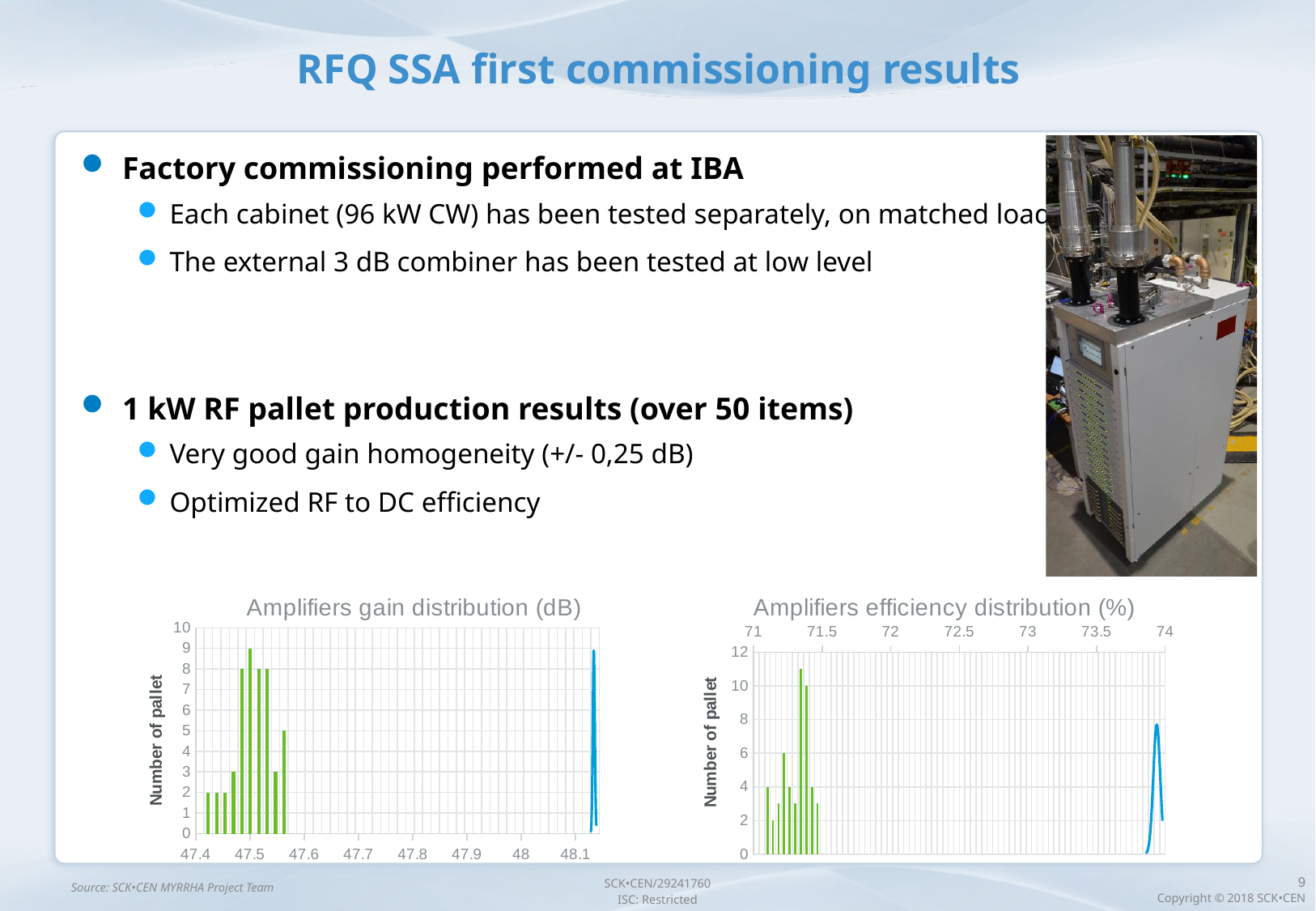
In the 'Amplifiers efficiency distribution (%)' chart, is the leftmost bar greater or less than 6? less In the 'Amplifiers gain distribution (dB)' chart, is the tallest bar greater or less than 5? greater What is the title of the chart on the right of the slide? Amplifiers efficiency distribution (%) What is the highest value shown on the y-axis of the 'Amplifiers efficiency distribution (%)' chart? 12 In the 'Amplifiers gain distribution (dB)' chart, what is the height of the tallest bar? 9 In the 'Amplifiers gain distribution (dB)' chart, is the rightmost bar greater or less than 4? greater In the 'Amplifiers efficiency distribution (%)' chart, is the tallest bar located below 72 or above 72 on the x-axis? below 72 In the 'Amplifiers gain distribution (dB)' chart, are the bars near 47.5 taller or shorter than the bars near 47.4? taller What is the y-axis label of the 'Amplifiers gain distribution (dB)' chart? Number of pallet What kind of chart is the 'Amplifiers gain distribution (dB)' chart? bar chart